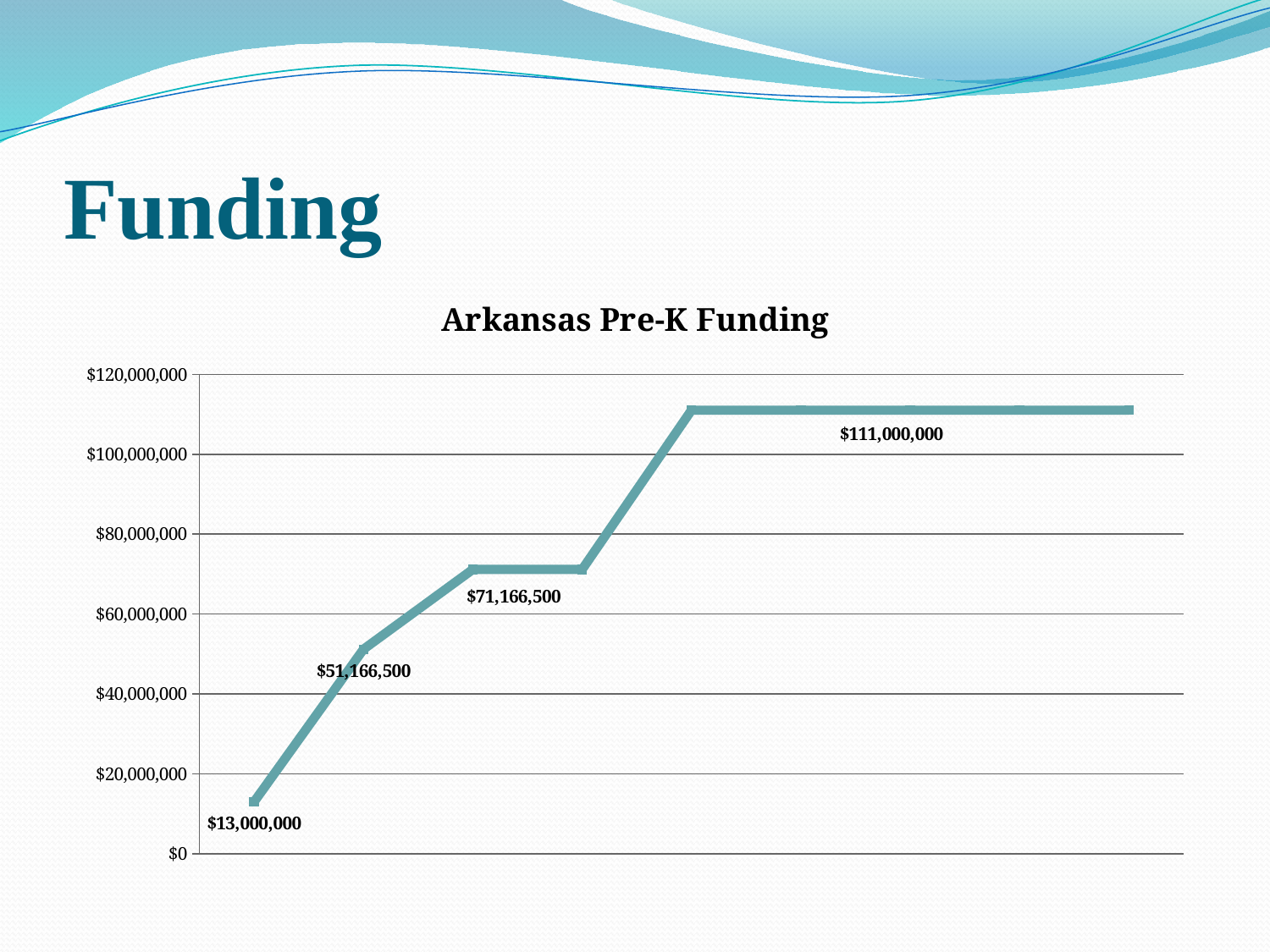
What is the lowest value labeled on the line? $13,000,000 What is the value of the first (leftmost) data point on the line? $13,000,000 Is the value of the plateau at the right end of the line greater or less than $100,000,000? greater What is the maximum value shown on the vertical axis? $120,000,000 What is the title of the chart? Arkansas Pre-K Funding Does the funding generally rise or fall from left to right along the x axis? rise What is the difference between the highest labeled value ($111,000,000) and the lowest labeled value ($13,000,000)? $98,000,000 Which is larger, the value labeled $51,166,500 or the value labeled $71,166,500? $71,166,500 What is the highest value labeled on the line? $111,000,000 What kind of chart is shown on the slide? line chart Is the value of the first data point greater or less than $20,000,000? less What is the difference between the $71,166,500 label and the $51,166,500 label? $20,000,000